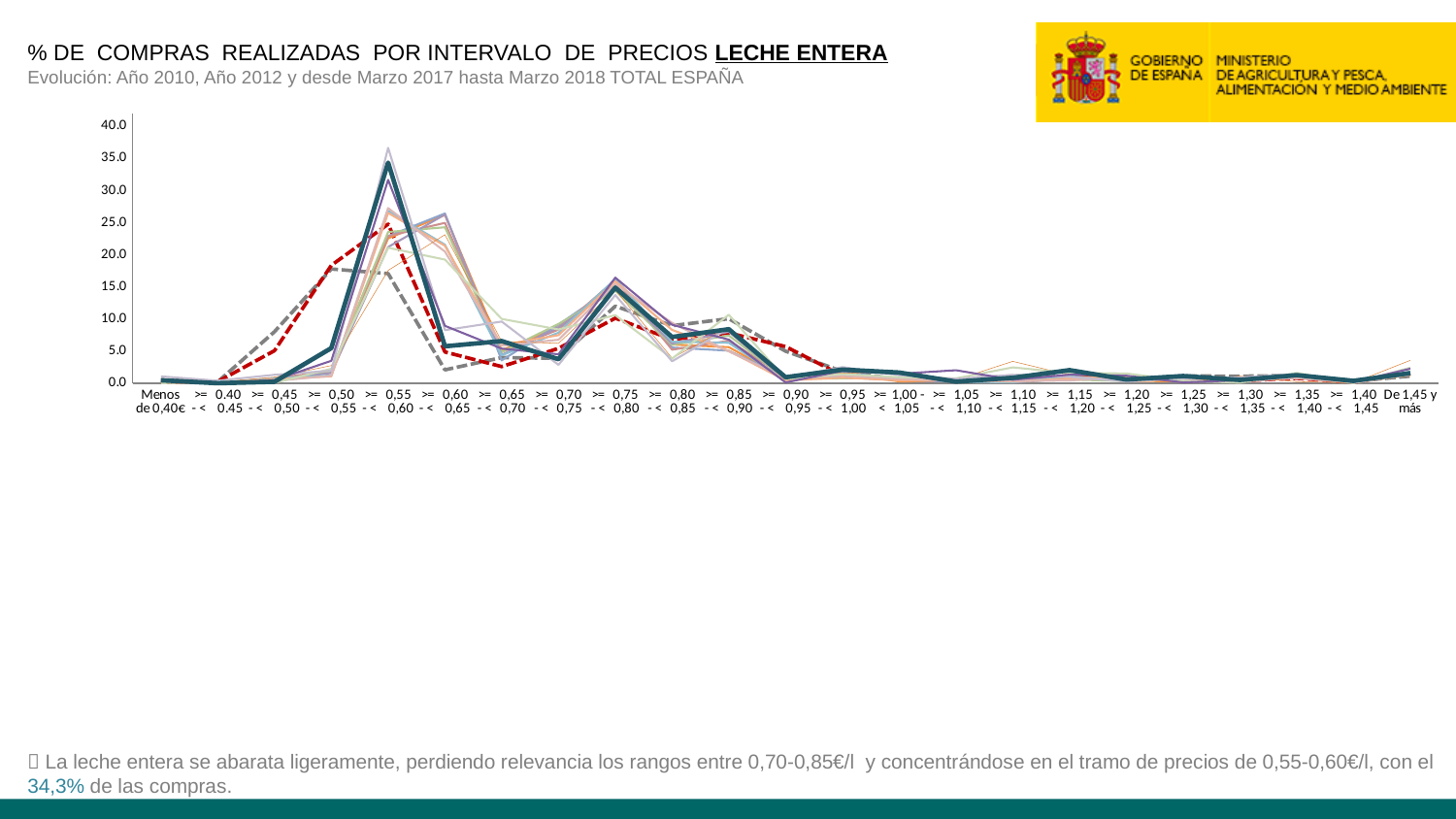
What is the highest tick value shown on the y axis of the chart? 40.0 What product does the chart title say the price intervals refer to? LECHE ENTERA Are the values of all lines at the >= 1,00 - < 1,05 interval greater or less than 5.0? less What kind of chart is shown on the slide? line chart How many price intervals (categories) are shown along the x axis of the chart? 23 Is the peak value of the thick dark line at the >= 0,55 - < 0,60 interval greater or less than 30? greater Is the value of the thick dark line at the >= 0,75 - < 0,80 interval greater or less than 20? less For the thick dark line, which is larger: the value at >= 0,55 - < 0,60 or the value at >= 0,75 - < 0,80? >= 0,55 - < 0,60 In which price interval does the thick dark line reach its highest value? >= 0,55 - < 0,60